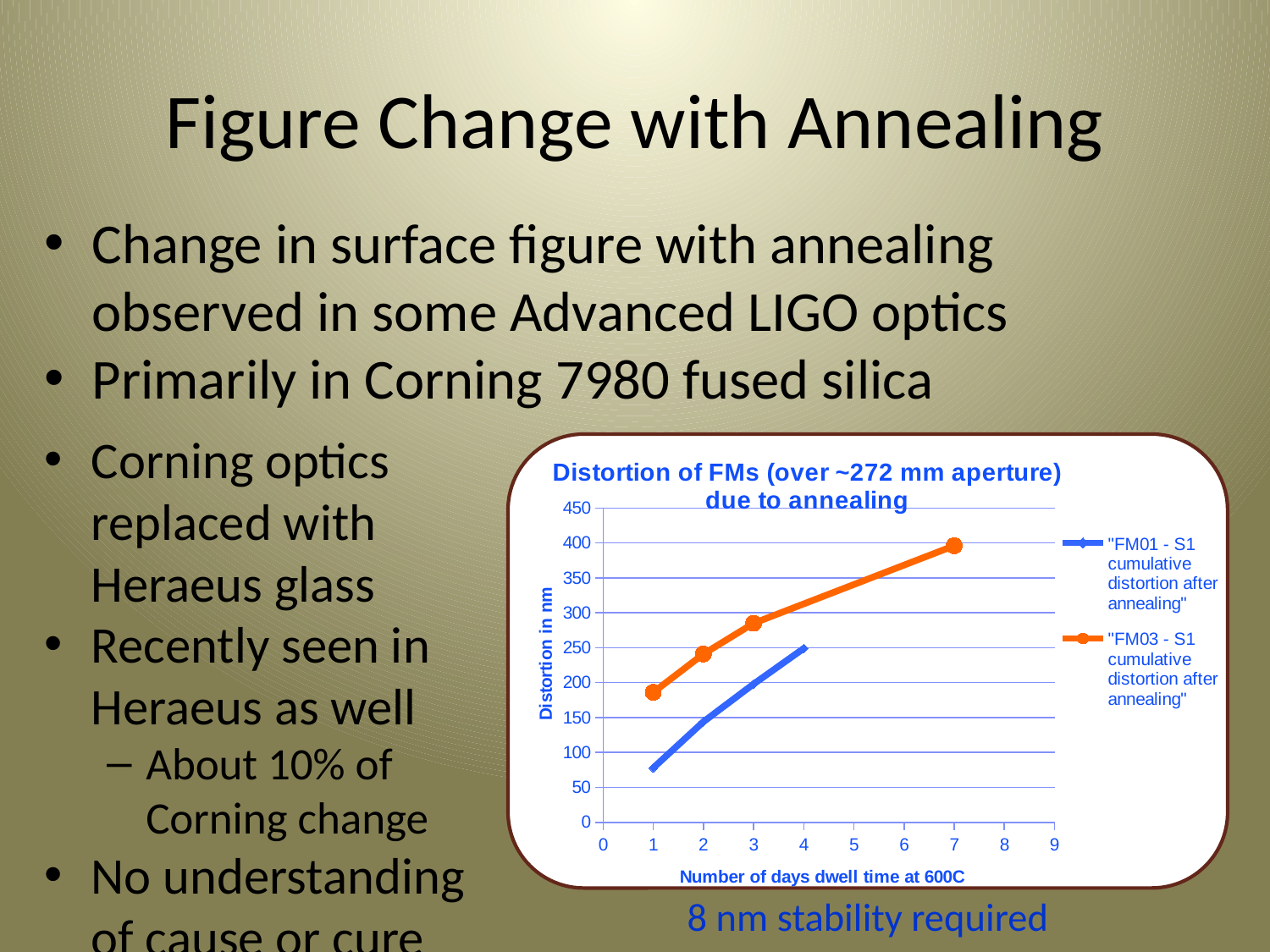
Is the FM03 distortion at 3 days greater or less than 250? greater How many data points are plotted for the FM03 series? 4 How many data points are plotted for the FM01 series? 4 Is the FM01 distortion at 1 day greater or less than 100? less What is the title of the chart's y axis? Distortion in nm At 2 days dwell time, which series shows the larger distortion, FM01 or FM03? FM03 Does the distortion for FM03 rise or fall as the number of days increases? rise Is the FM03 distortion at 1 day greater or less than 150? greater What is the title of the chart's x axis? Number of days dwell time at 600C How many series does the chart legend list? 2 What kind of chart is shown on the slide? line chart